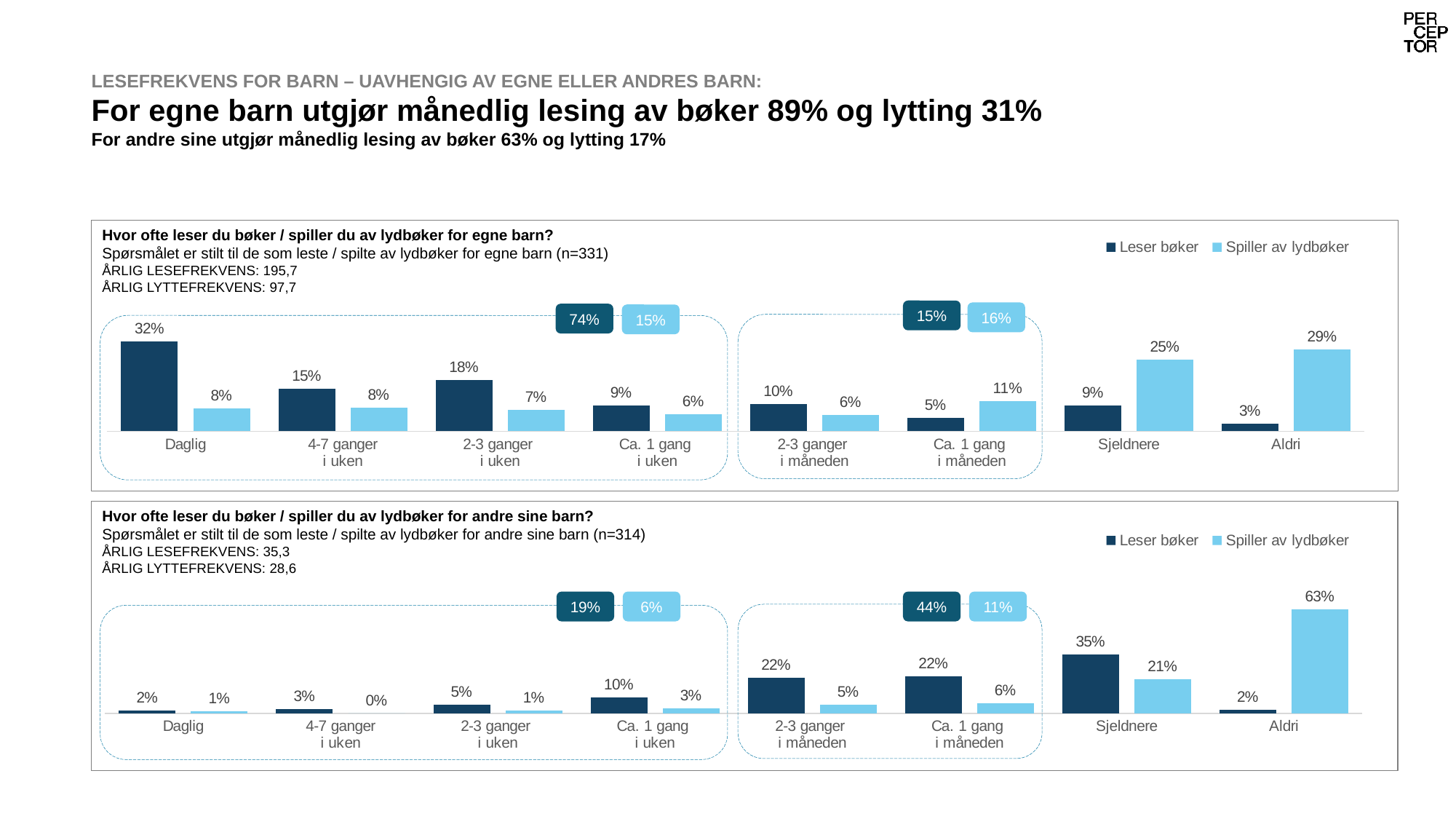
How many categories are shown on the x axis of the bottom chart (for andre sine barn)? 8 In the top chart (for egne barn), what is the value for 'Spiller av lydbøker' in the 'Aldri' category? 29% In the top chart (for egne barn), which is larger for 'Ca. 1 gang i måneden': 'Leser bøker' or 'Spiller av lydbøker'? Spiller av lydbøker In the top chart (for egne barn), what is the value for 'Leser bøker' in the 'Daglig' category? 32% In the bottom chart (for andre sine barn), which category has the lowest 'Spiller av lydbøker' value? 4-7 ganger i uken In the bottom chart (for andre sine barn), what is the difference between 'Leser bøker' and 'Spiller av lydbøker' for 'Sjeldnere'? 14 percentage points In the top chart (for egne barn), what is the difference between 'Leser bøker' and 'Spiller av lydbøker' for 'Daglig'? 24 percentage points In the bottom chart (for andre sine barn), what is the value for 'Spiller av lydbøker' in the 'Aldri' category? 63% How many series does the legend of the top chart (for egne barn) list? 2 What kind of chart is the top chart (for egne barn)? Bar chart In the bottom chart (for andre sine barn), which category has the highest 'Leser bøker' value? Sjeldnere In the top chart (for egne barn), which category has the highest 'Leser bøker' value? Daglig